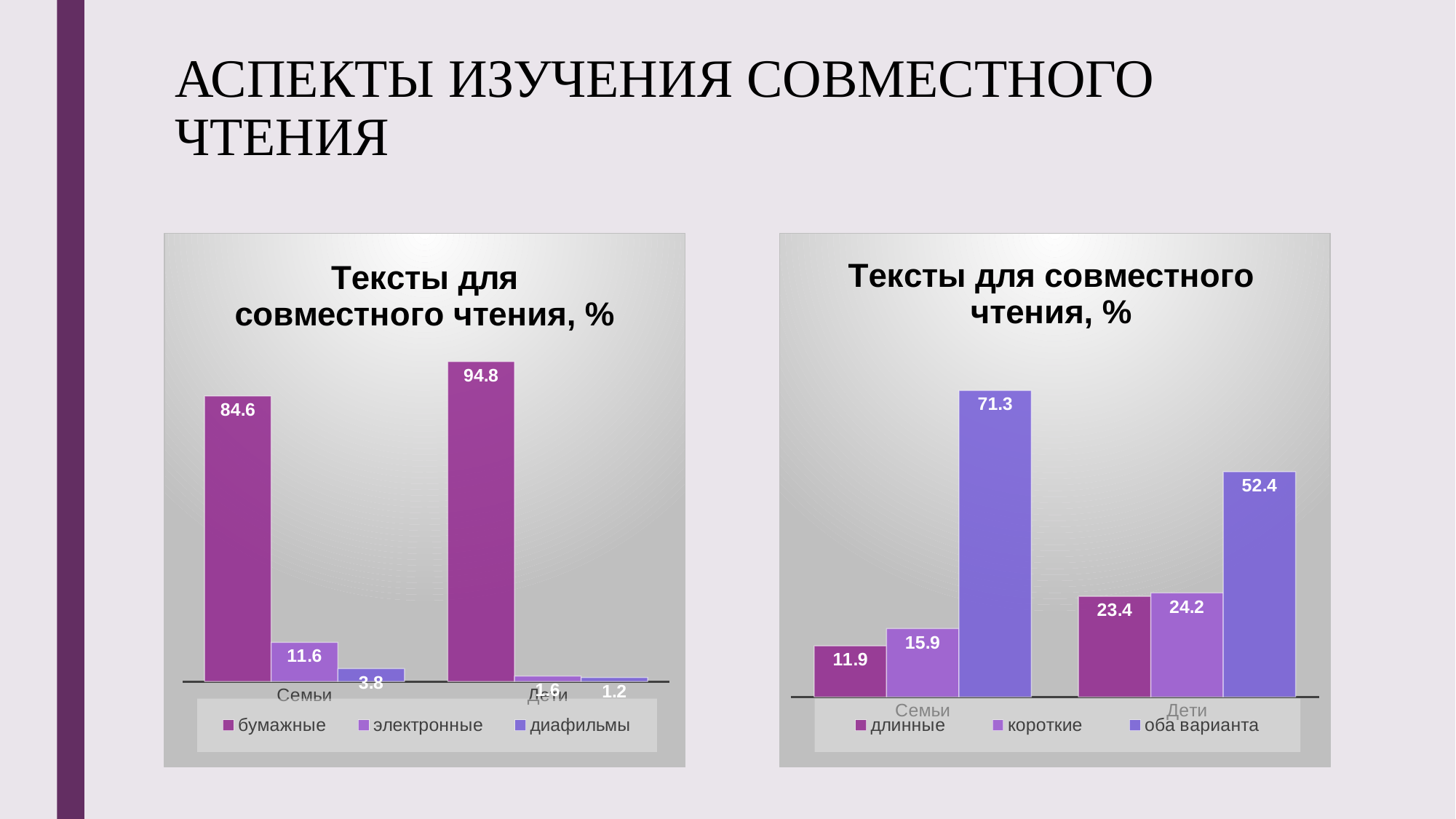
In the left chart, what is the value for бумажные in the Дети category? 94.8 In the right chart, what is the value for короткие in the Дети category? 24.2 In the left chart, what is the difference between бумажные for Дети and бумажные for Семьи? 10.2 In the left chart, how many series does the legend list? 3 In the right chart, which is larger: длинные for Дети or длинные for Семьи? длинные for Дети In the left chart, what is the value for электронные in the Семьи category? 11.6 In the left chart, what is the value for бумажные in the Семьи category? 84.6 In the left chart, which series has the highest value in the Семьи category? бумажные In the right chart, which series has the lowest value in the Семьи category? длинные In the right chart, what is the difference between оба варианта for Семьи and оба варианта for Дети? 18.9 What type of chart is the right chart? bar chart In the right chart, what is the value for оба варианта in the Семьи category? 71.3